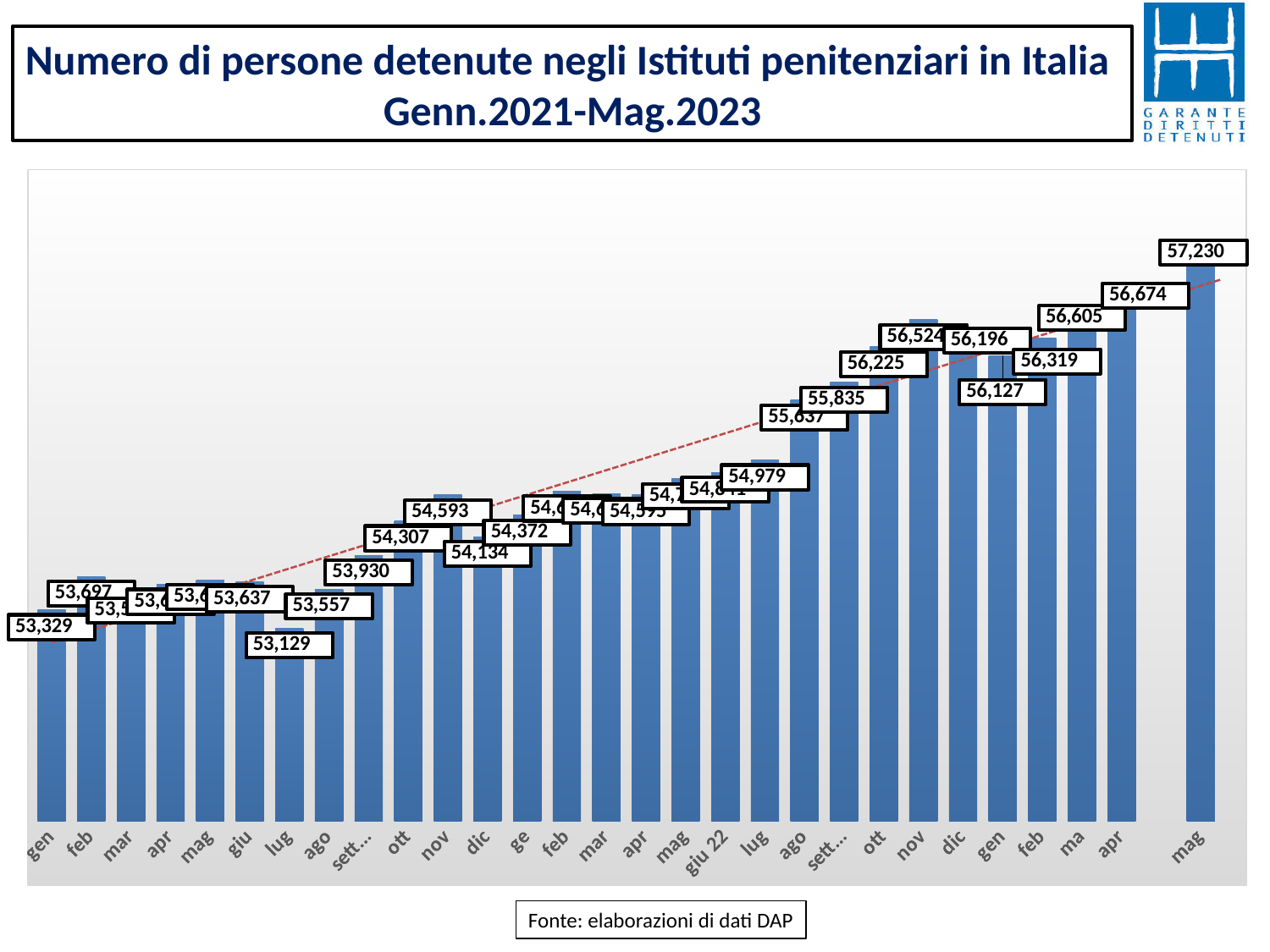
Which month has the highest number of detainees? mag 2023 What is the value for the first bar (gen 2021)? 53,329 What is the lowest value shown on the chart? 53,129 What kind of chart is shown on the slide? bar chart What is the value for the last bar (mag 2023)? 57,230 What is the difference between the value for mag 2023 and the value for gen 2021? 3,901 How many bars (months) are plotted on the chart? 29 Which is larger, the value for gen 2021 or the value for mag 2023? mag 2023 What is the value for feb 2021? 53,697 What is the title of the chart? Numero di persone detenute negli Istituti penitenziari in Italia Genn.2021-Mag.2023 Do the values generally rise or fall from left to right along the x axis? rise What source is cited below the chart? Fonte: elaborazioni di dati DAP